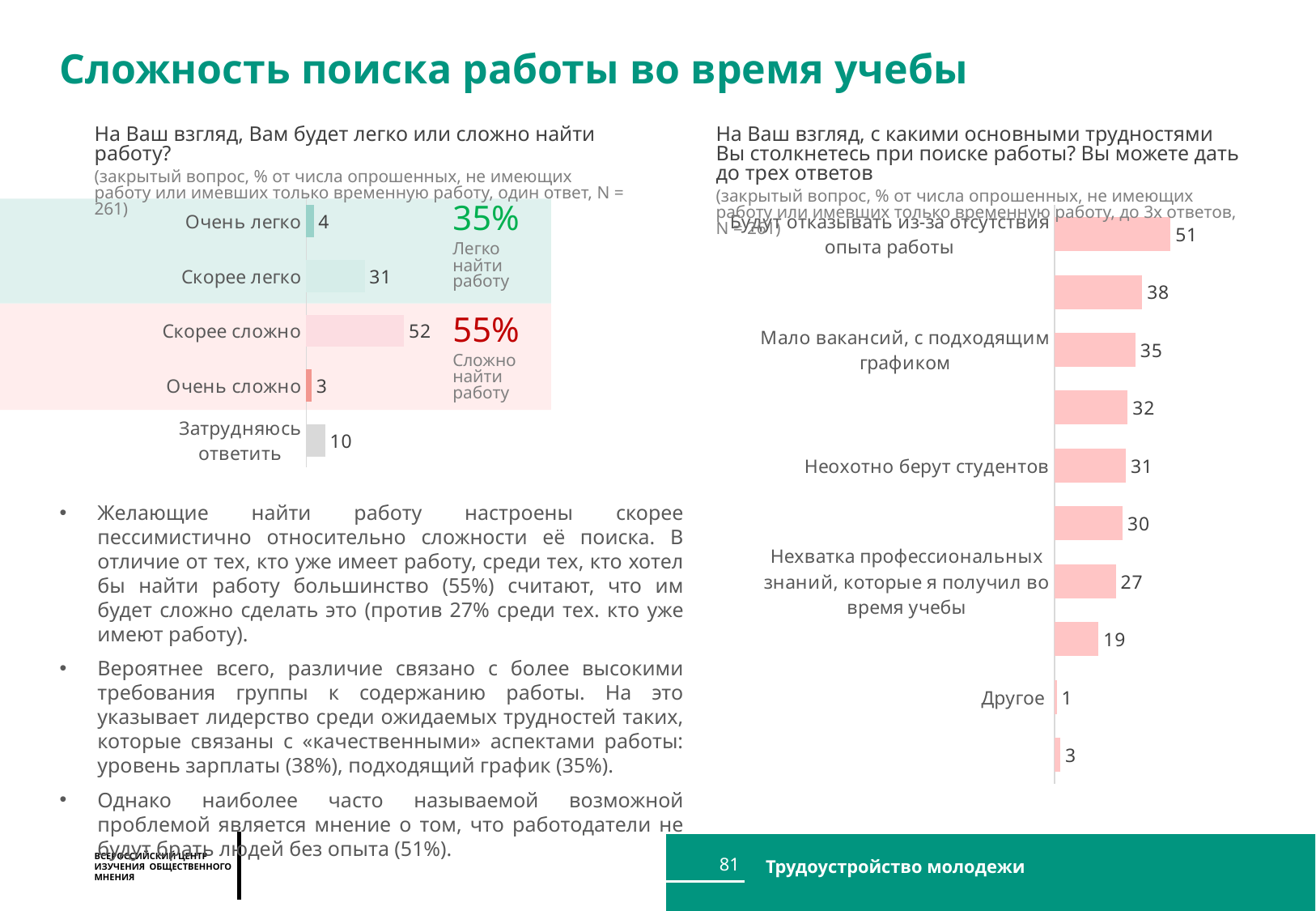
In the right chart, which is larger: "Мало вакансий, с подходящим графиком" or "Нехватка профессиональных знаний, которые я получил во время учебы"? Мало вакансий, с подходящим графиком In the left chart, what is the value for "Скорее сложно"? 52 In the right chart, how many bars are plotted? 10 What type of chart is the right chart? Bar chart In the right chart, what is the value for "Неохотно берут студентов"? 31 In the left chart, which category has the highest value? Скорее сложно In the right chart, what is the value for "Мало вакансий, с подходящим графиком"? 35 In the left chart, which category has the lowest value? Очень сложно In the left chart, how many categories are shown? 5 In the left chart, what is the value for "Скорее легко"? 31 In the right chart, what is the value for "Будут отказывать из-за отсутствия опыта работы"? 51 In the left chart, what is the difference between "Скорее сложно" and "Скорее легко"? 21